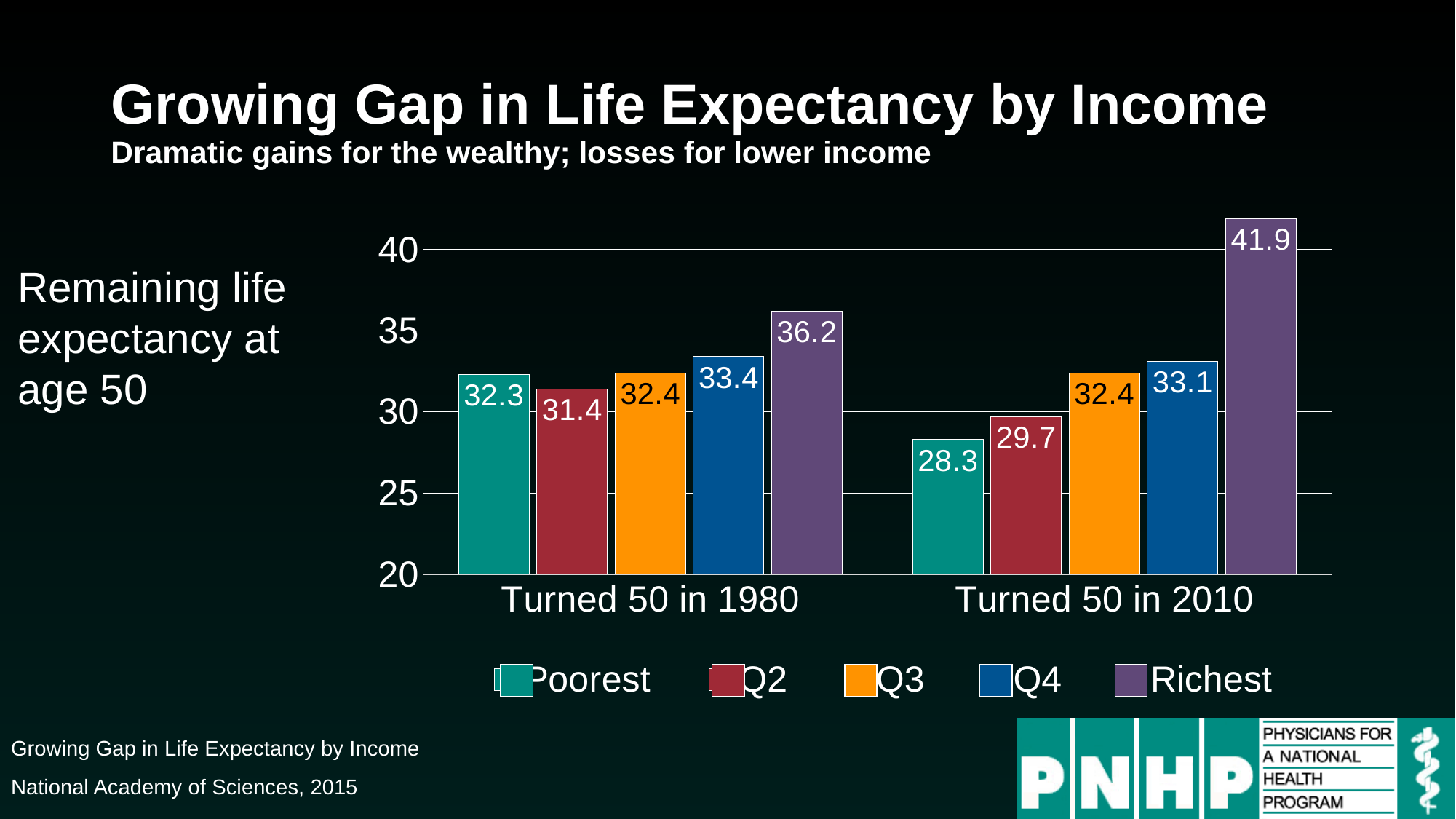
Is the value for the Richest group who turned 50 in 2010 greater or less than 40? greater How many series does the legend list? 5 What is the value for Q2 among those who turned 50 in 2010? 29.7 What is the difference between the Richest and Poorest values for those who turned 50 in 2010? 13.6 Which income group has the lowest value among those who turned 50 in 1980? Q2 What kind of chart is shown on the slide? Bar chart What is the remaining life expectancy at age 50 for the Richest group who turned 50 in 2010? 41.9 Which income group has the highest value among those who turned 50 in 2010? Richest Which is larger: the Poorest value for the 1980 cohort or the Poorest value for the 2010 cohort? Turned 50 in 1980 What is the value for the Poorest group who turned 50 in 1980? 32.3 By how much did the Richest group's value change from the 1980 cohort to the 2010 cohort? 5.7 What colour represents the Q3 series in the chart? Orange